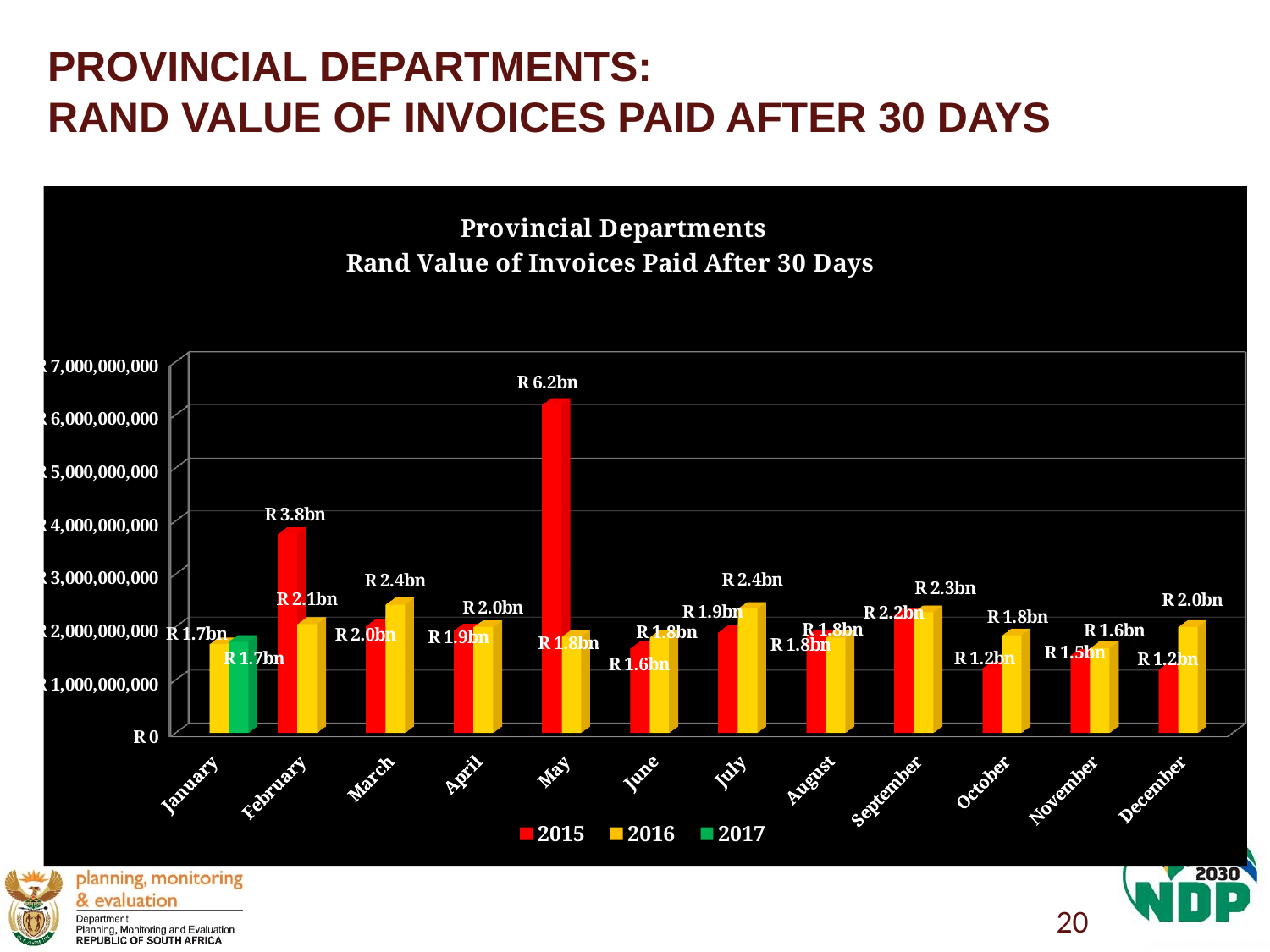
What is the 2016 value for July? R 2.4bn What is the 2015 value for February? R 3.8bn What is the 2015 value for May? R 6.2bn How many series does the legend list? 3 What is the difference between the 2015 value for May and the 2016 value for May? R 4.4bn What is the 2017 value for January? R 1.7bn Which month has the highest 2015 value? May Which month has the lowest 2016 value? November Is the 2015 value for February greater or less than R 3,000,000,000? greater How many months are shown on the x axis? 12 What kind of chart is shown on the slide? Bar chart Which is larger for October, the 2015 value or the 2016 value? 2016